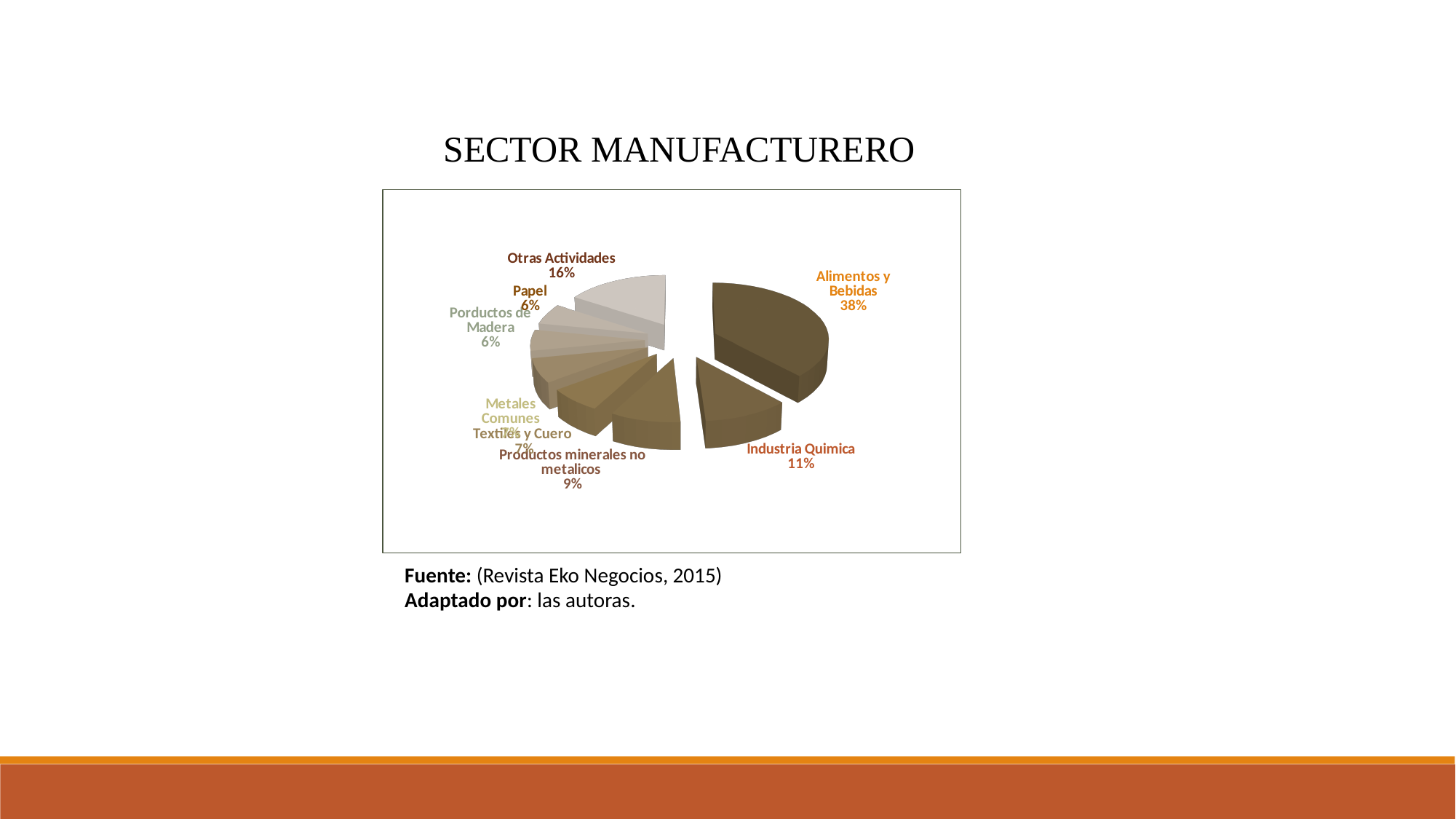
What percentage is shown for Productos minerales no metalicos? 9% How many percentage points larger is Alimentos y Bebidas than Industria Quimica? 27 percentage points Which is larger, Otras Actividades or Industria Quimica? Otras Actividades What percentage is shown for Otras Actividades? 16% What is the title of the slide above the chart? SECTOR MANUFACTURERO What percentage is shown for Industria Quimica? 11% Which category has the largest slice of the pie? Alimentos y Bebidas What percentage is shown for Textiles y Cuero? 7% What percentage is shown for Papel? 6% What share of the pie does Alimentos y Bebidas have? 38% What kind of chart is shown on the slide? pie chart How many categories are shown in the pie chart? 8